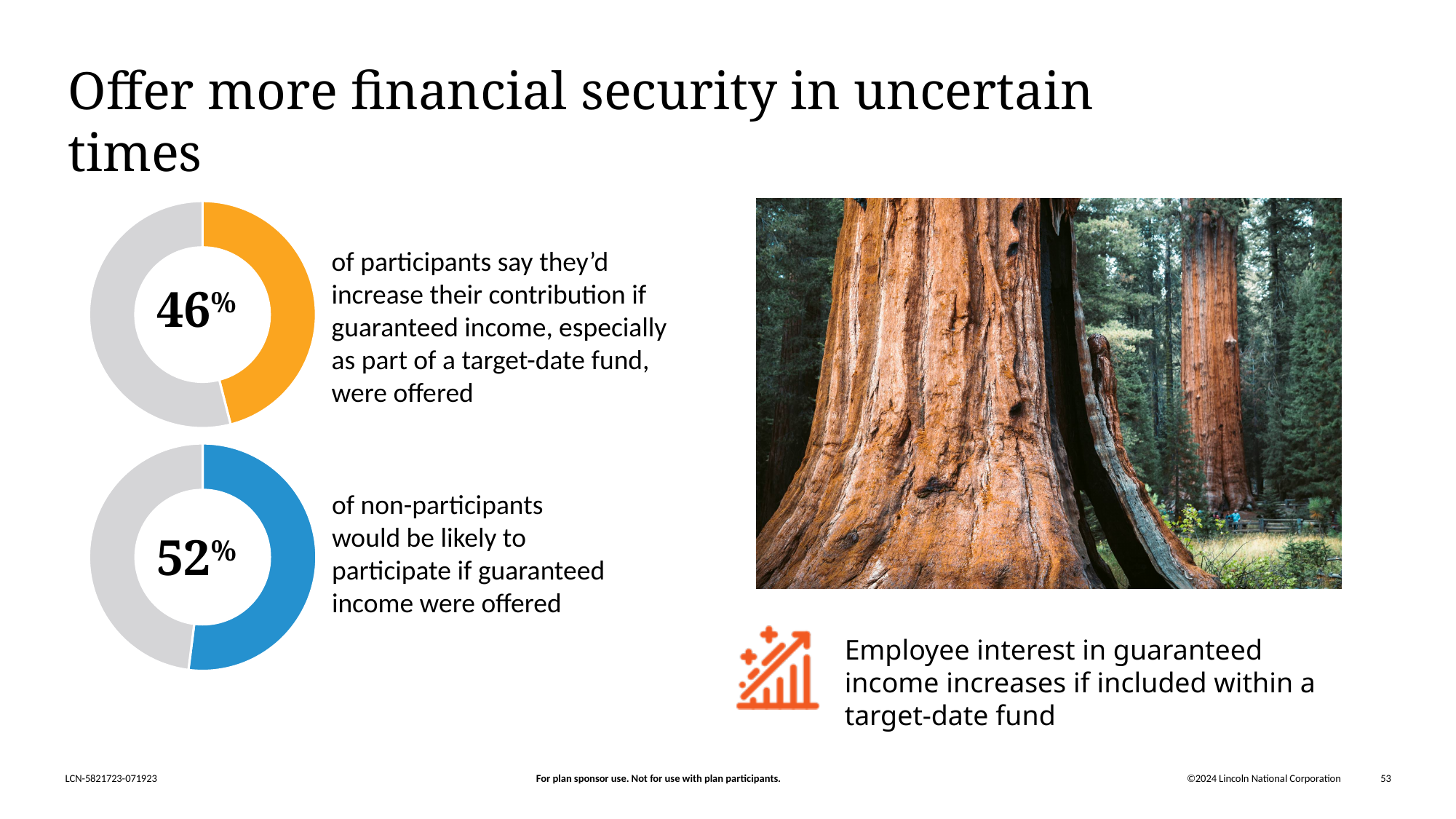
Which is larger: the value in the top donut chart (participants) or the bottom donut chart (non-participants)? The bottom donut chart (52%) What value is shown in the bottom donut chart on the left of the slide? 52% How many donut charts are on the slide? 2 What colour is the filled segment of the top donut chart showing 46%? Orange What percentage of non-participants would be likely to participate if guaranteed income were offered? 52% Is the value in the bottom donut chart greater or less than 50%? greater What is the difference between the value in the bottom donut chart and the value in the top donut chart? 6 percentage points What kind of charts are shown on the left side of the slide? Donut (pie) charts What colour is the filled segment of the bottom donut chart showing 52%? Blue What percentage of participants say they'd increase their contribution if guaranteed income were offered? 46% Is the value in the top donut chart greater or less than 50%? less What value is shown in the top donut chart on the left of the slide? 46%